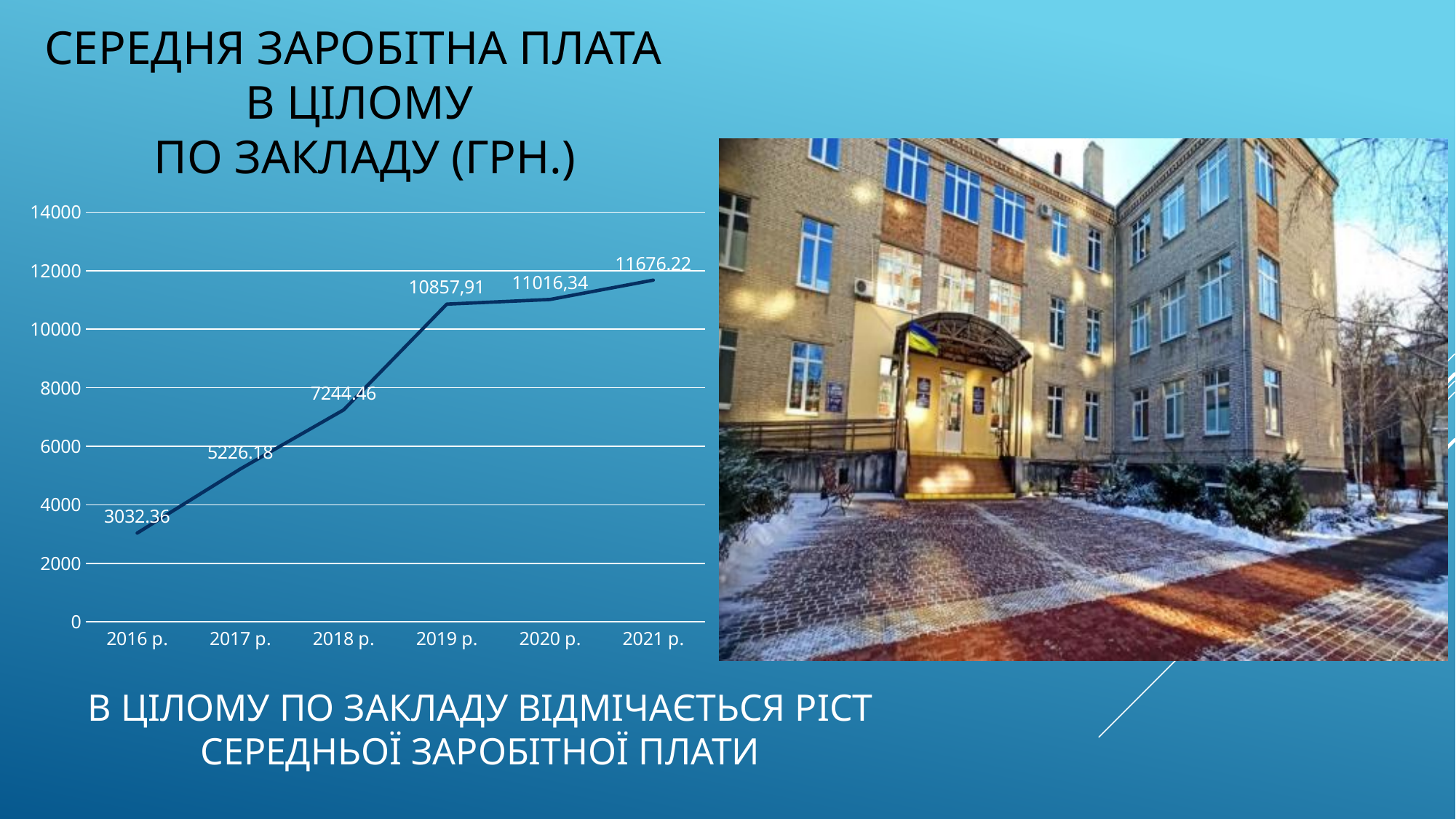
Which year has the highest value on the chart? 2021 р. What is the value shown for 2021 р.? 11676.22 Which is larger, the value for 2017 р. or the value for 2018 р.? 2018 р. What is the difference between the values for 2018 р. and 2017 р.? 2018.28 How many years are plotted on the x axis? 6 What is the average salary value shown for 2016 р.? 3032.36 What is the value shown for 2018 р.? 7244.46 Which year has the lowest value on the chart? 2016 р. Do the values rise or fall from 2016 р. to 2021 р.? rise What is the value shown for 2019 р.? 10857,91 What type of chart is shown on the slide? line chart What is the difference between the values for 2021 р. and 2016 р.? 8643.86